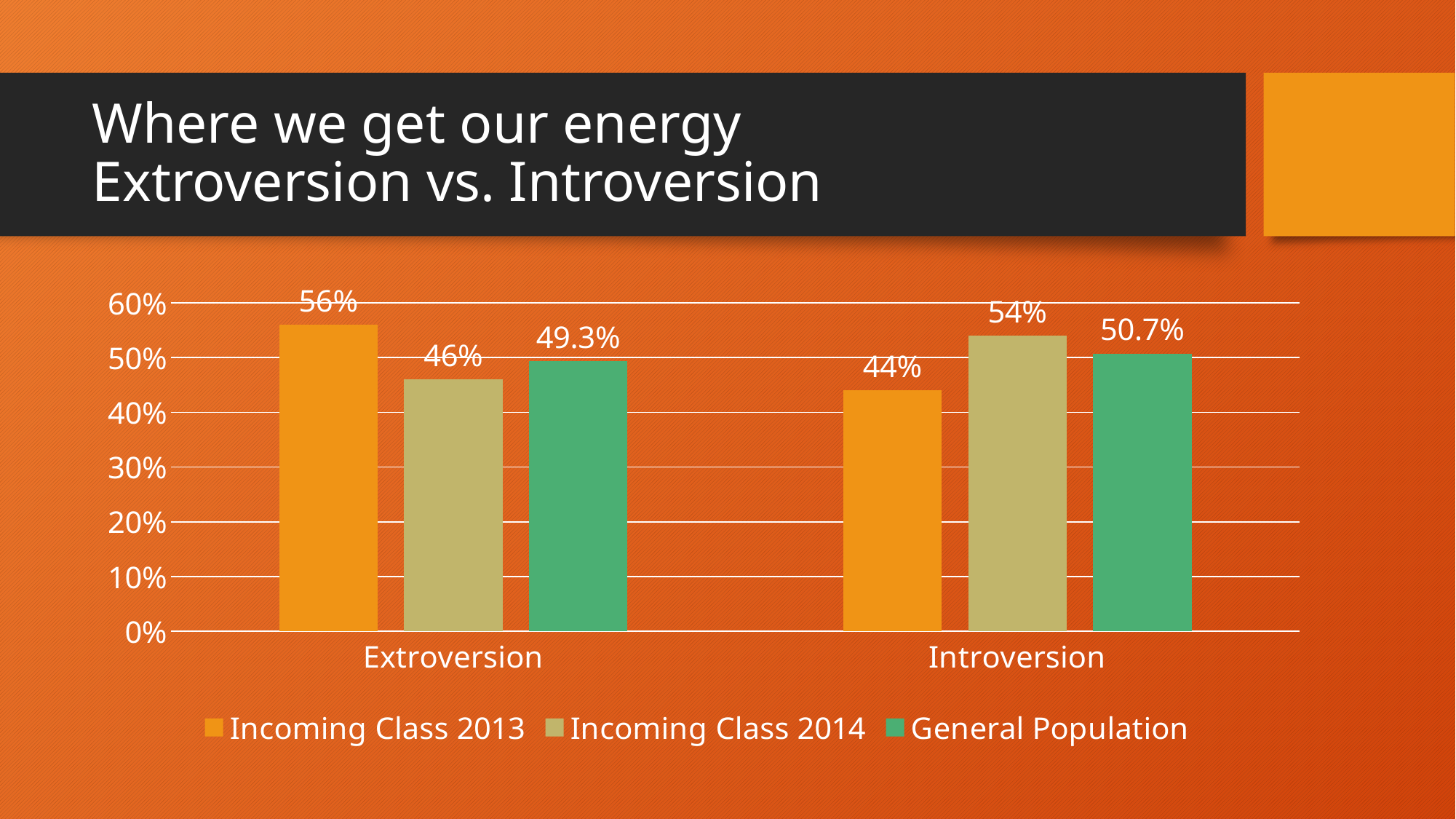
Which series has the highest value for Extroversion? Incoming Class 2013 What is the difference between the Incoming Class 2013 values for Extroversion and Introversion? 12% How many series does the legend list? 3 Which is larger: the Incoming Class 2014 value for Extroversion or for Introversion? Introversion What is the Incoming Class 2014 value for Introversion? 54% What is the General Population value for Introversion? 50.7% What is the General Population value for Extroversion? 49.3% Which series has the lowest value for Introversion? Incoming Class 2013 How many categories are shown on the x axis? 2 What kind of chart is shown on the slide? Bar chart What colour are the General Population bars? Green What is the Incoming Class 2013 value for Extroversion? 56%